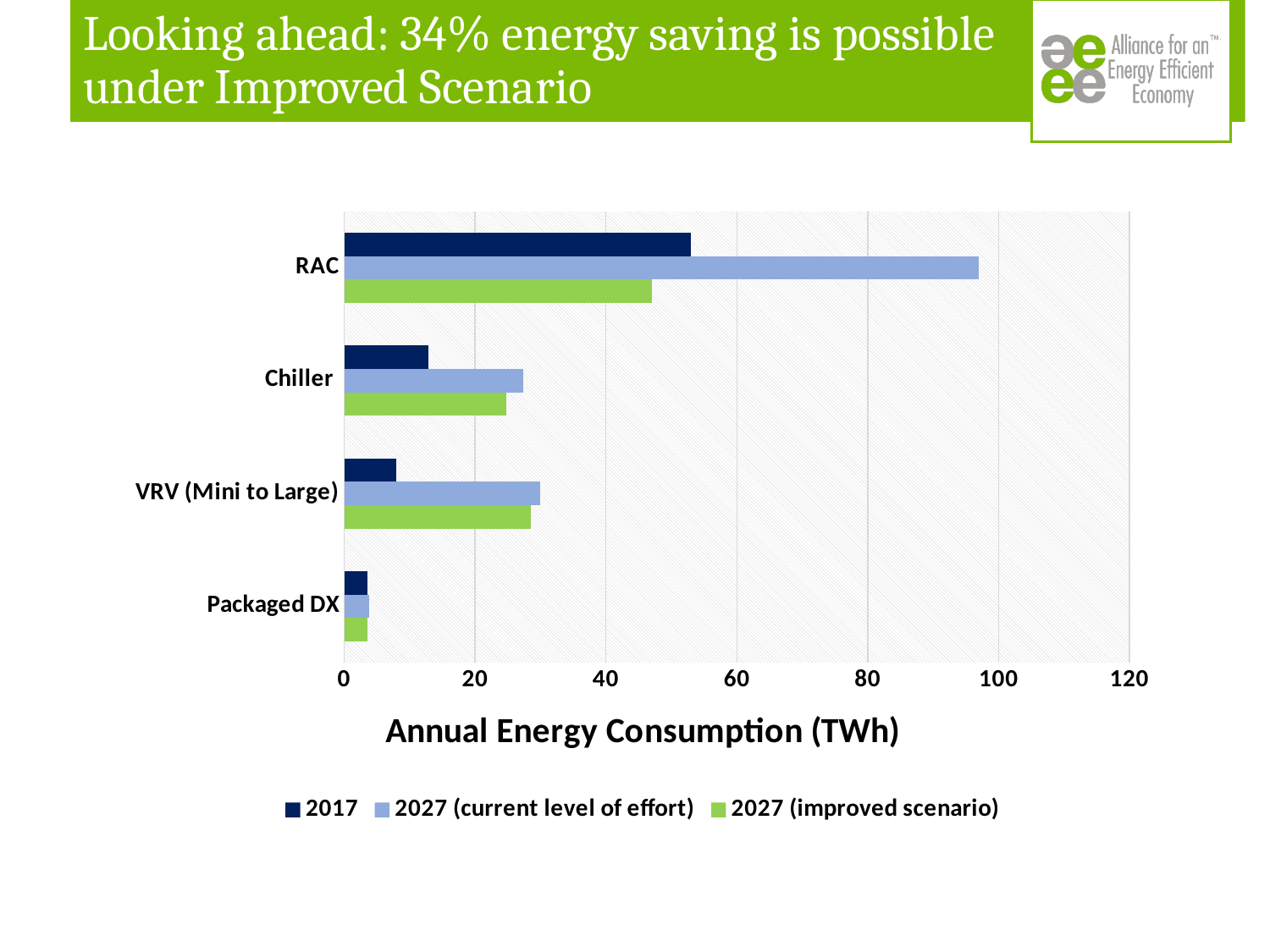
For RAC, which is larger: the 2017 value or the 2027 (current level of effort) value? 2027 (current level of effort) How many equipment categories are shown on the chart? 4 Is the 2017 value for RAC greater or less than 40? greater Is the 2027 (current level of effort) value for Chiller greater or less than 20? greater Which category has the highest 2027 (current level of effort) value? RAC Is the 2017 value for Packaged DX greater or less than 20? less Which category has the lowest 2017 value? Packaged DX Which series is shown in green in the legend? 2027 (improved scenario) What is the title of the horizontal axis? Annual Energy Consumption (TWh) How many series does the legend list? 3 What kind of chart is shown on the slide? bar chart